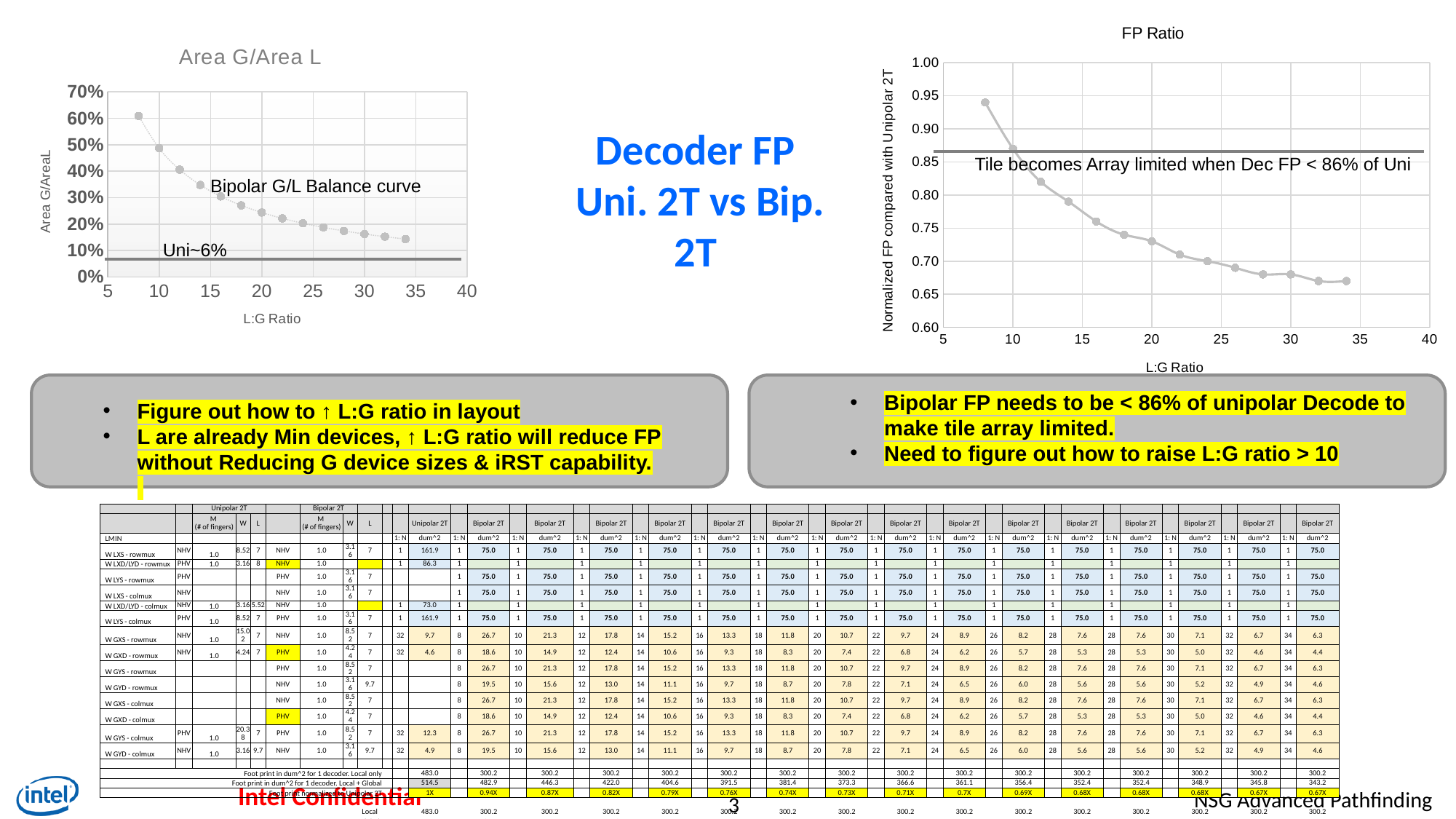
What is the y-axis label of the FP Ratio chart? Normalized FP compared with Unipolar 2T In the Area G/Area L chart, is the value at an L:G ratio of 20 greater or less than 30%? less In the Area G/Area L chart, is the value at an L:G ratio of 34 greater or less than 20%? less In the FP Ratio chart, is the value at an L:G ratio of 20 greater or less than 0.70? greater In the Area G/Area L chart, at which L:G ratio is the plotted value highest? 8 What kind of chart is the Area G/Area L chart? line chart In the Area G/Area L chart, do the plotted values rise or fall as the L:G ratio increases? fall In the Area G/Area L chart, what label is shown on the horizontal reference line? Uni~6%